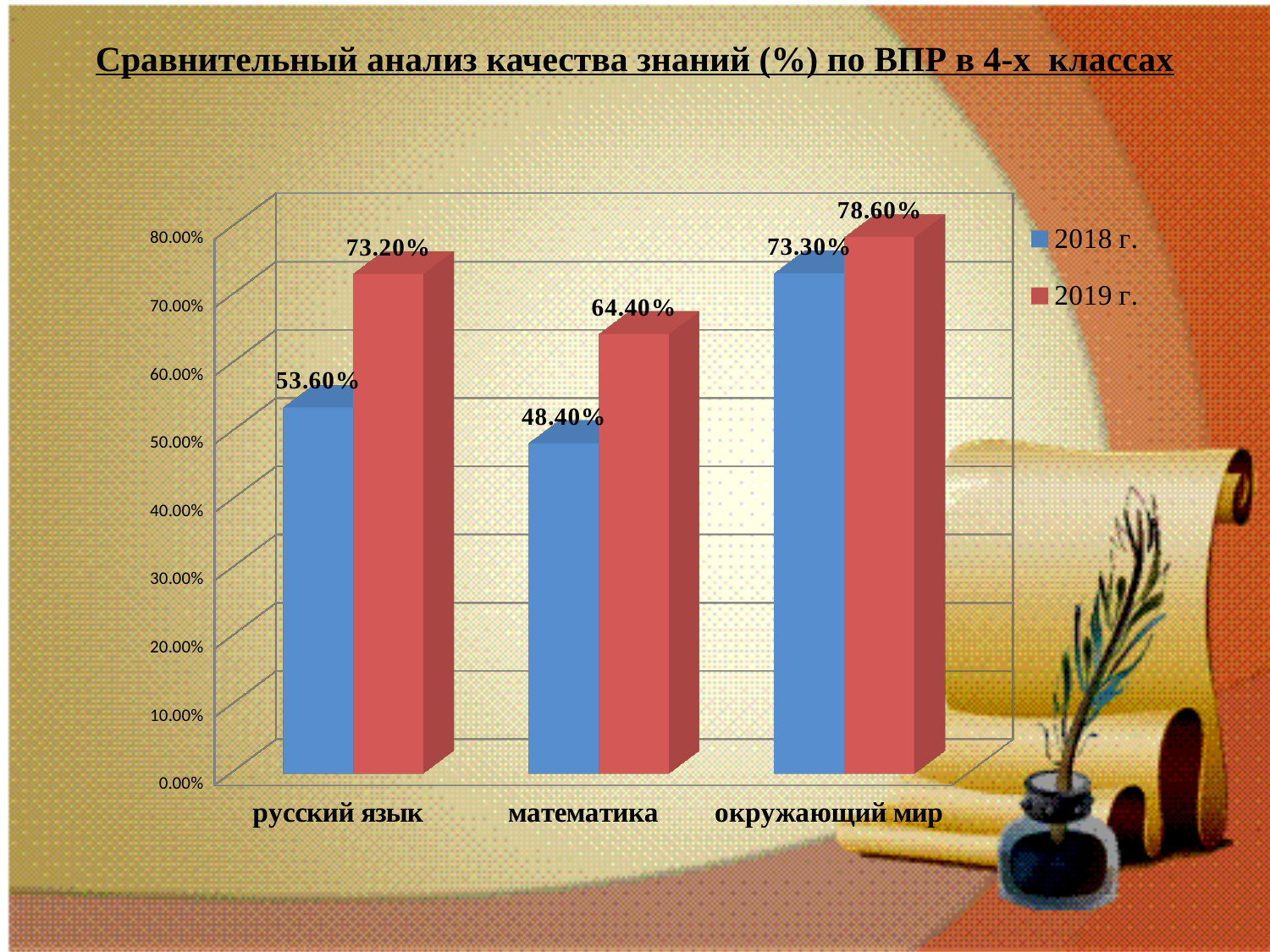
How many series does the legend list? 2 Which subject has the lowest value in 2018 г.? математика What is the value for русский язык in 2018 г.? 53.60% What is the value for математика in 2019 г.? 64.40% Which is larger: the 2018 г. value for окружающий мир or the 2019 г. value for русский язык? 2018 г. value for окружающий мир How many subjects are shown on the x axis? 3 What is the difference between the 2019 г. and 2018 г. values for русский язык? 19.60% What kind of chart is shown on the slide? bar chart Which colour represents 2019 г. in the chart? red Which subject has the highest value in 2019 г.? окружающий мир What is the difference between the 2019 г. and 2018 г. values for математика? 16.00% What is the value for окружающий мир in 2018 г.? 73.30%